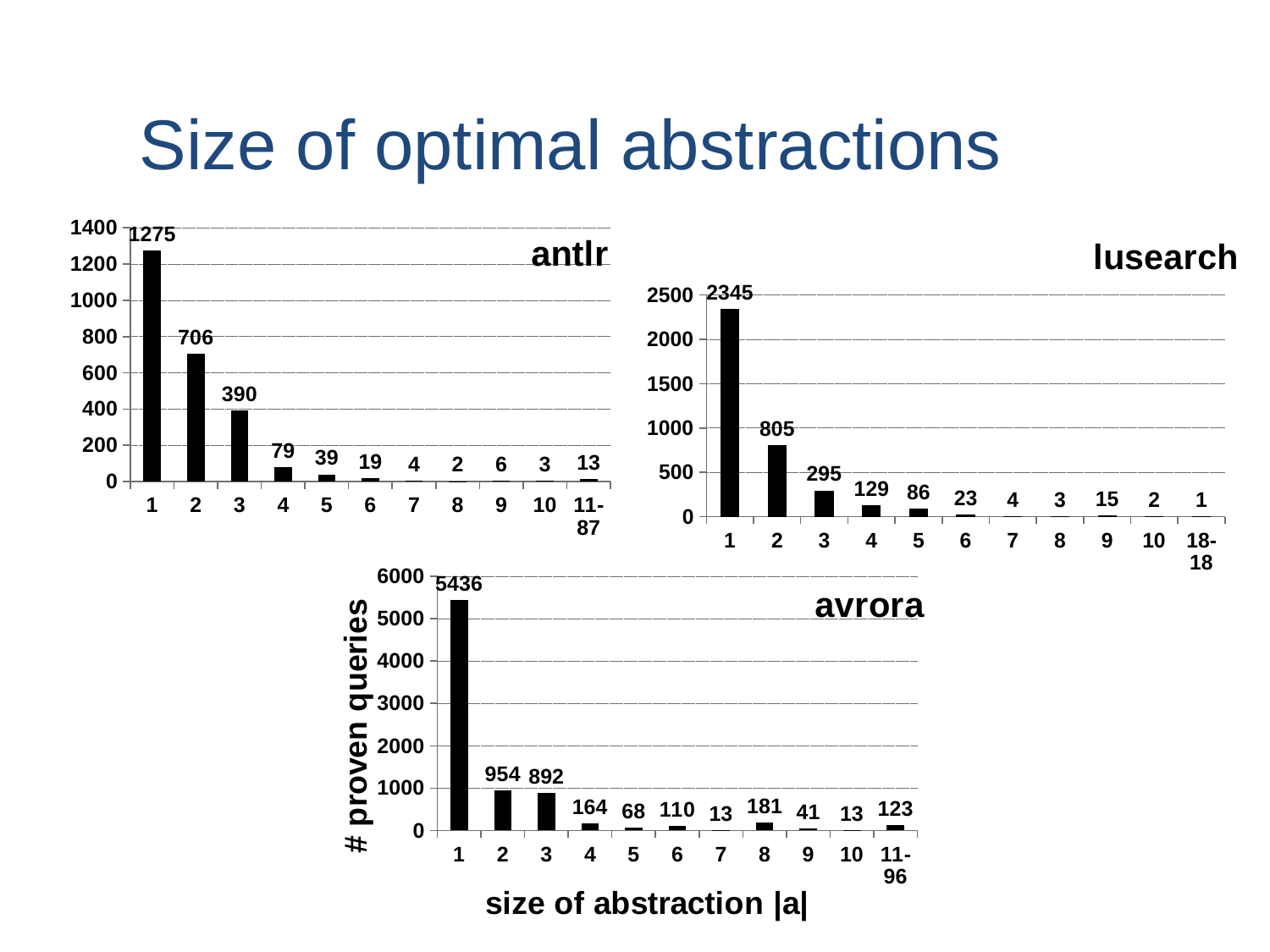
In the avrora chart, which is larger, the value for abstraction size 6 or size 8? 8 In the avrora chart, what is the value for abstraction size 8? 181 In the lusearch chart, which category has the lowest value? 18-18 In the antlr chart, what is the difference between the values for abstraction sizes 1 and 2? 569 In the avrora chart, what is the difference between the values for abstraction sizes 2 and 3? 62 In the lusearch chart, what is the value for abstraction size 4? 129 In the avrora chart, which abstraction size has the highest number of proven queries? 1 In the antlr chart, what is the value for abstraction size 2? 706 What kind of chart is the avrora chart? bar chart How many categories are shown on the x axis of the antlr chart? 11 In the lusearch chart, is the value for abstraction size 2 greater or less than 1000? less What is the y-axis label on the avrora chart? # proven queries